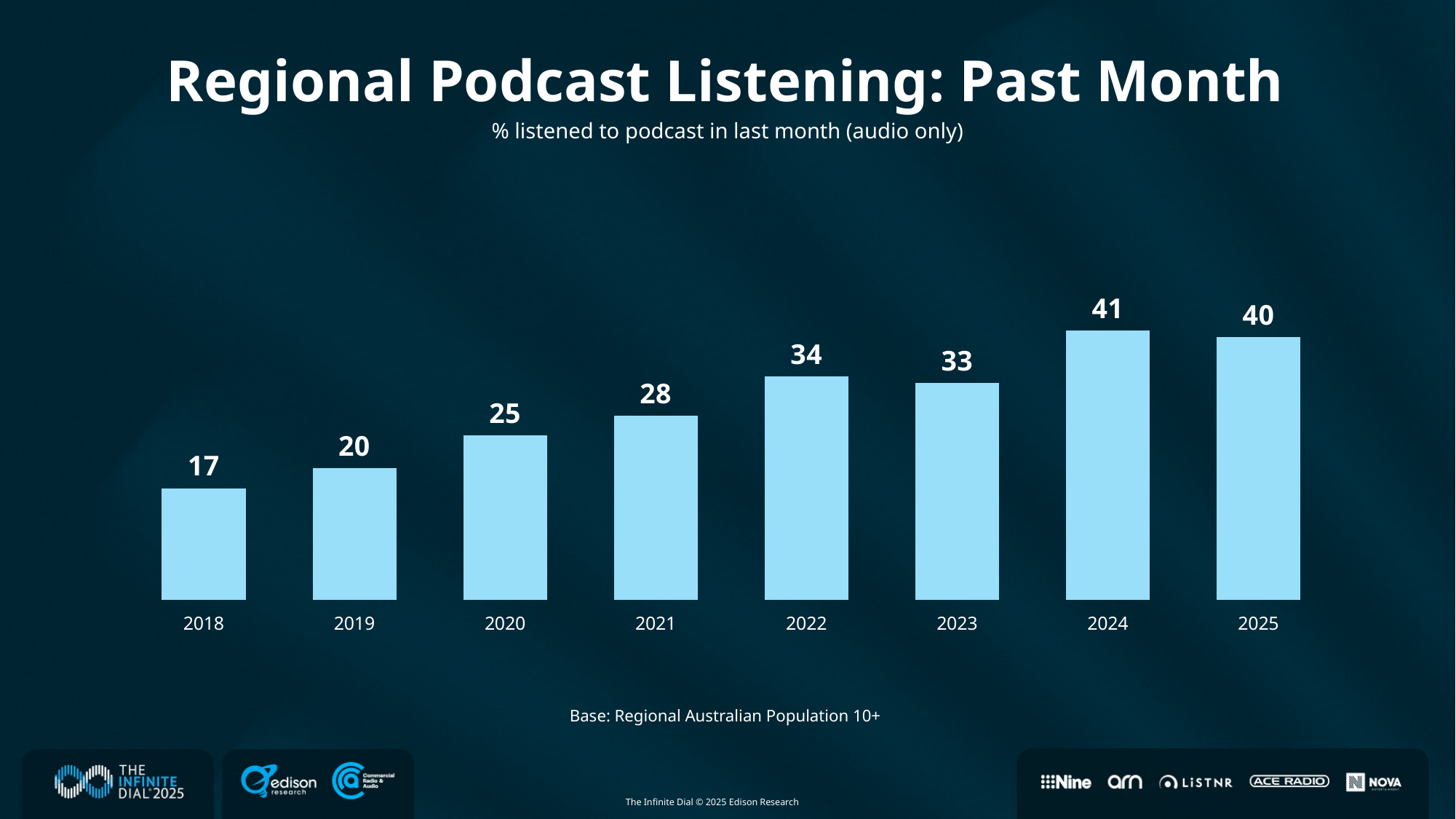
Which is larger, the value for 2020 or the value for 2021? 2021 Which year has the highest value? 2024 What is the value for 2022? 34 How many years are shown on the chart? 8 What is the difference between the values for 2024 and 2018? 24 What is the value for 2018? 17 What is the value for 2025? 40 What kind of chart is this? bar chart What is the difference between the values for 2023 and 2022? 1 Which year has the lowest value? 2018 What is the title of the chart? Regional Podcast Listening: Past Month Do the values generally rise or fall from 2018 to 2024? rise